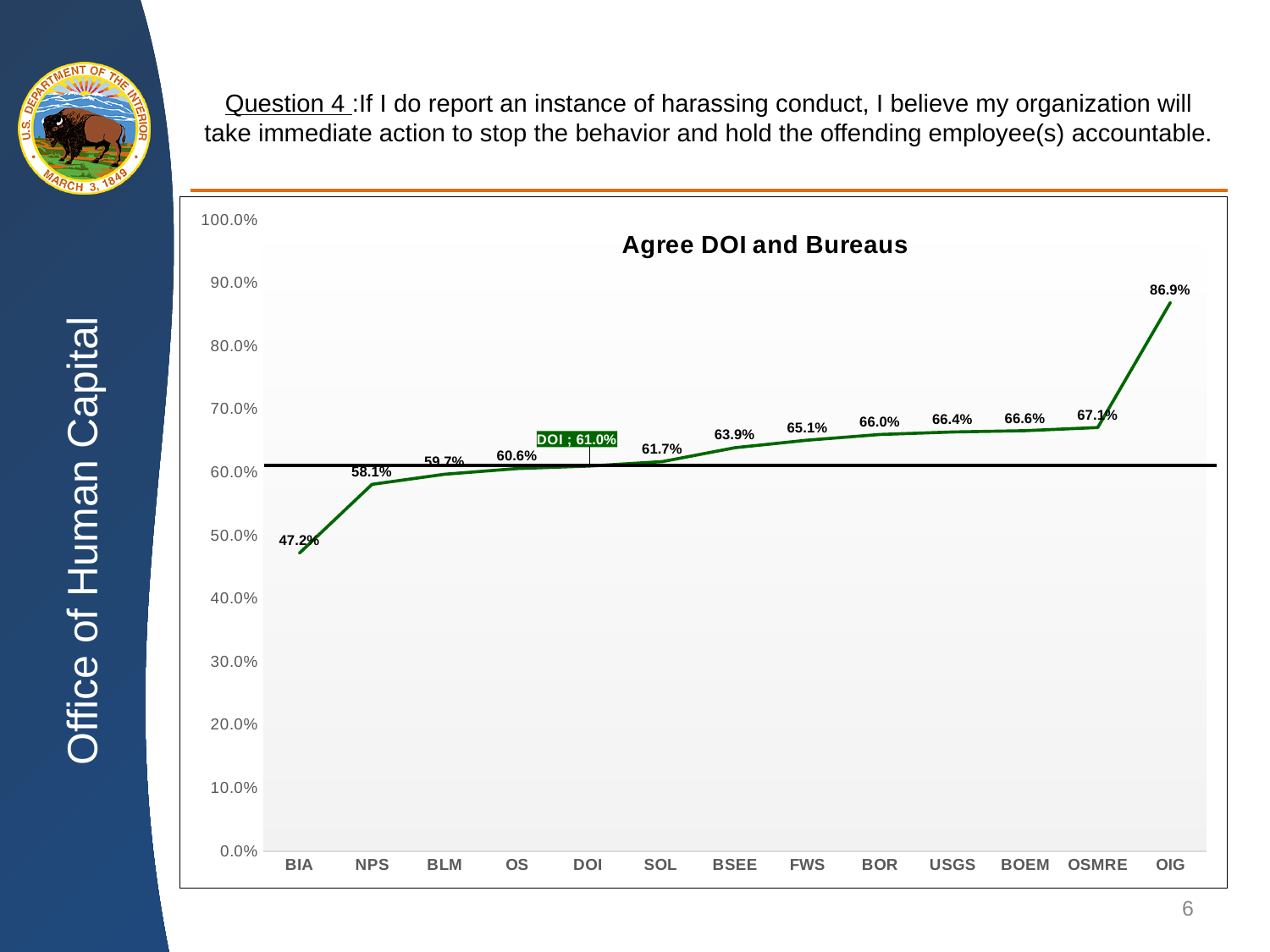
What kind of chart is shown on the slide? line chart What is the value for BIA? 47.2% Which category has the lowest value? BIA What is the value for OIG? 86.9% What is the value for DOI? 61.0% What is the title of the chart? Agree DOI and Bureaus Which category has the highest value? OIG How many categories are plotted on the x axis? 13 Do the values generally rise or fall from left to right along the x axis? rise What is the difference between the values for OIG and BIA? 39.7% Which has a larger value, BSEE or NPS? BSEE What is the value for FWS? 65.1%